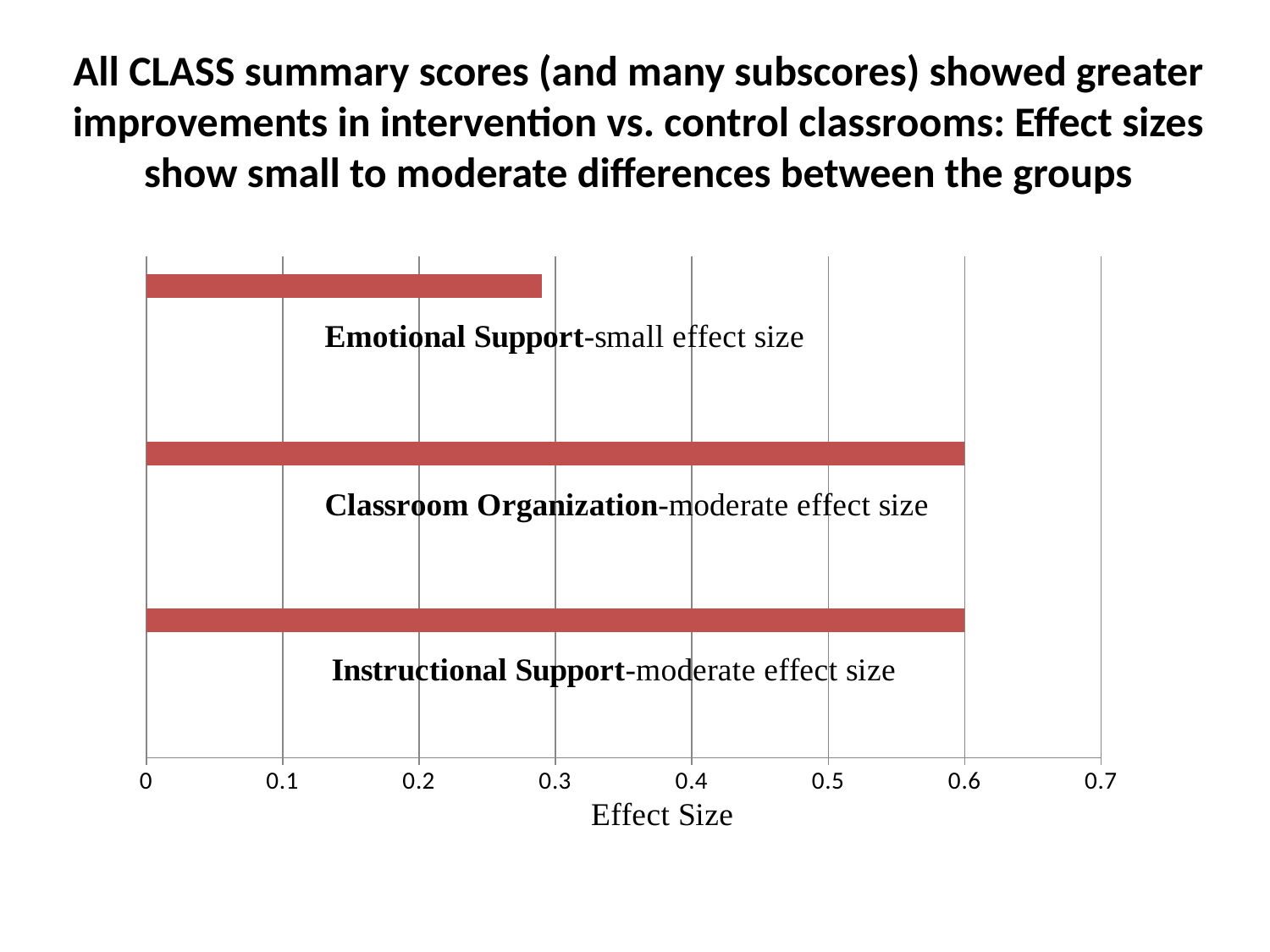
What is the effect size for Classroom Organization? 0.6 Is the effect size for Emotional Support greater or less than 0.2? greater Which has the larger effect size, Classroom Organization or Emotional Support? Classroom Organization Which has the larger effect size, Instructional Support or Emotional Support? Instructional Support What is the difference between the effect sizes for Classroom Organization and Instructional Support? 0 What is the highest value shown on the horizontal axis? 0.7 Which category has the smallest effect size? Emotional Support What kind of chart is shown on the slide? bar chart How many bars (categories) does the chart show? 3 Is the effect size for Emotional Support greater or less than 0.4? less What is the title of the horizontal axis? Effect Size What is the effect size for Instructional Support? 0.6